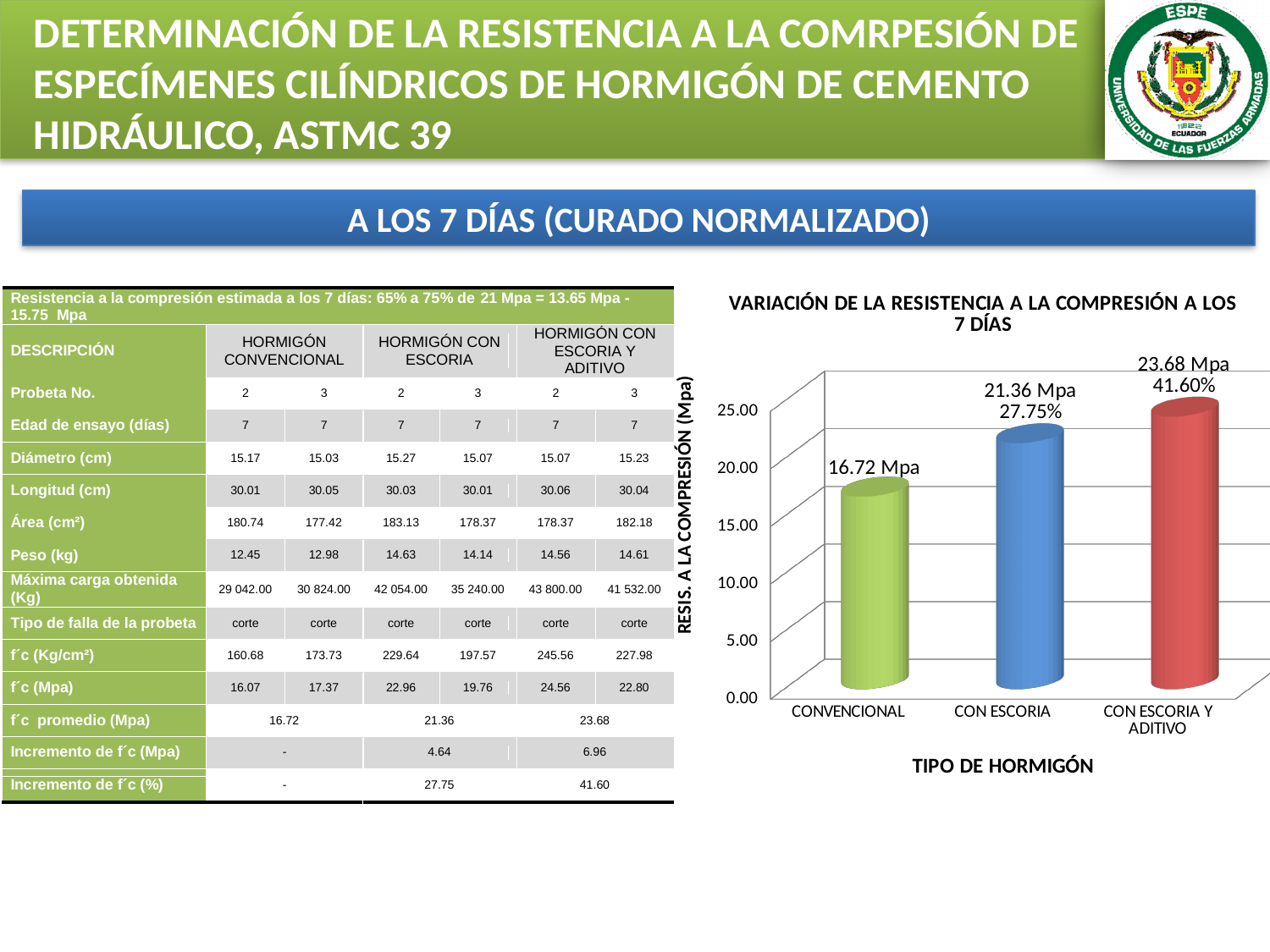
What is the value shown for CONVENCIONAL in the chart? 16.72 Mpa What percentage increase is labelled on the CON ESCORIA bar? 27.75% What is the title of the chart's x axis? TIPO DE HORMIGÓN What kind of chart is shown on the slide? Bar chart Which type of concrete has the highest compressive strength in the chart? CON ESCORIA Y ADITIVO What is the value shown for CON ESCORIA in the chart? 21.36 Mpa Which type of concrete has the lowest compressive strength in the chart? CONVENCIONAL What percentage increase is labelled on the CON ESCORIA Y ADITIVO bar? 41.60% What is the value shown for CON ESCORIA Y ADITIVO in the chart? 23.68 Mpa How many types of concrete are plotted in the chart? 3 Which is larger, the value for CON ESCORIA or the value for CONVENCIONAL? CON ESCORIA What is the difference in Mpa between CON ESCORIA Y ADITIVO and CONVENCIONAL? 6.96 Mpa